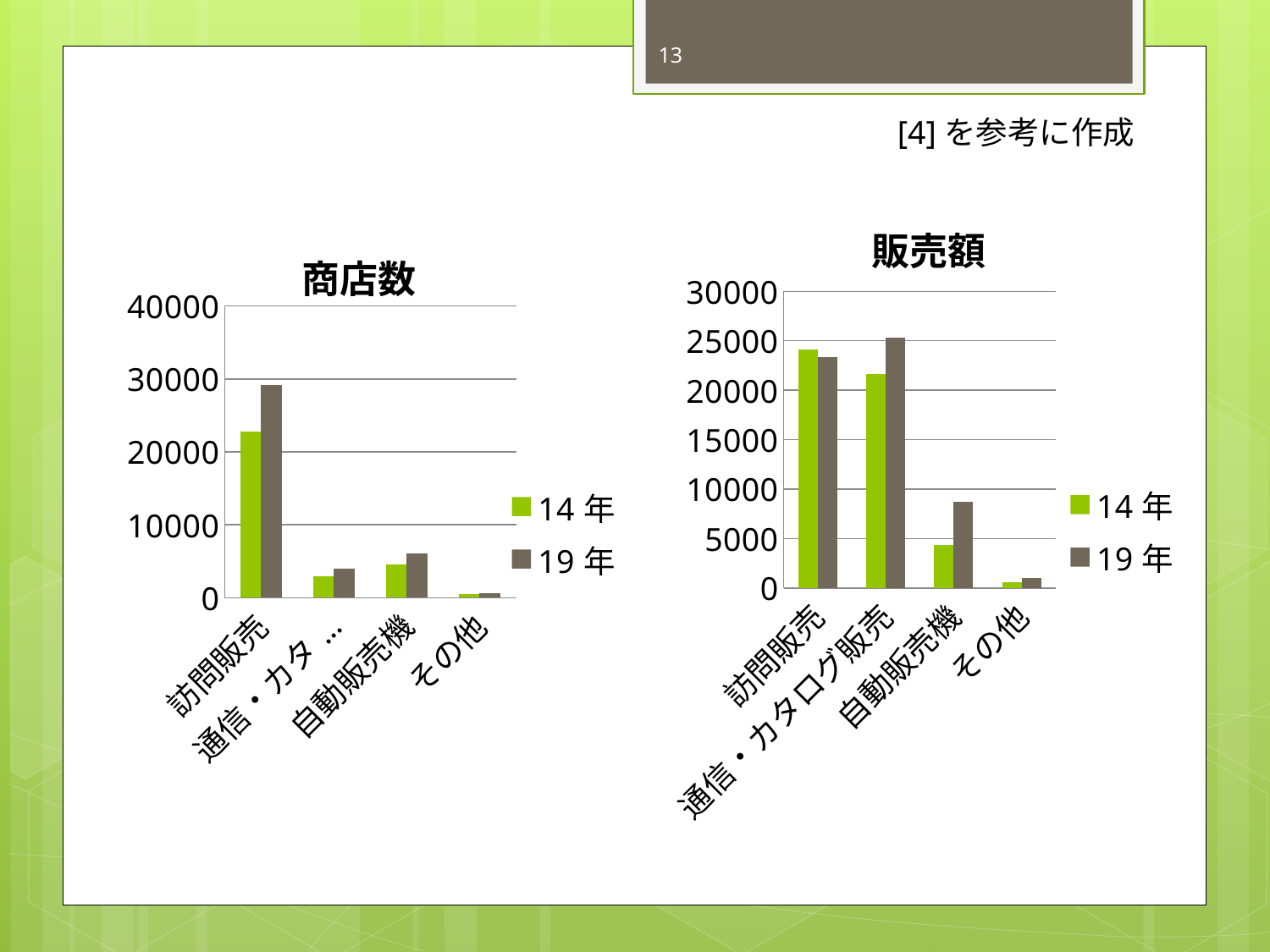
In the 販売額 chart, which category has the highest value for 19 年? 通信・カタログ販売 In the 商店数 chart, is the value for 自動販売機 in 19 年 greater or less than 10000? less How many series does the legend of the 販売額 chart list? 2 In the 商店数 chart, which category has the highest value for 19 年? 訪問販売 In the 商店数 chart, is the value for 訪問販売 in 19 年 greater or less than 20000? greater What kind of chart is the 商店数 chart on the left? bar chart How many categories are shown on the x axis of the 販売額 chart? 4 In the 商店数 chart, which category has the lowest value for 14 年? その他 In the 販売額 chart, is the value for 自動販売機 in 19 年 greater or less than 10000? less In the 販売額 chart, which is larger for 自動販売機: the 14 年 value or the 19 年 value? 19 年 What is the title of the chart on the right side of the slide? 販売額